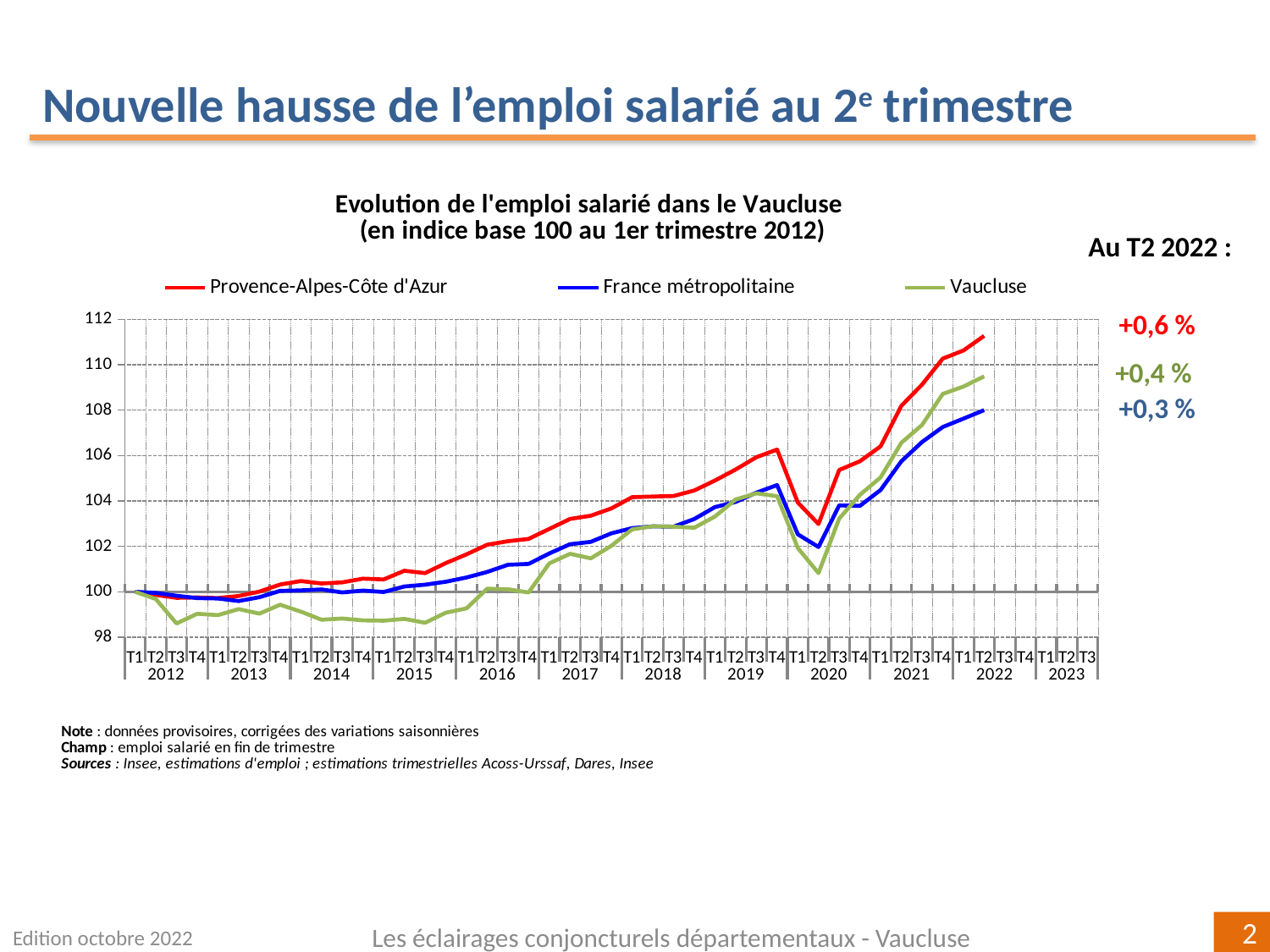
How many series does the legend list? 3 Is the value for Provence-Alpes-Côte d'Azur at T2 2022 greater or less than 110? greater What is the title of the chart? Evolution de l'emploi salarié dans le Vaucluse (en indice base 100 au 1er trimestre 2012) Is the value for Vaucluse at T2 2020 greater or less than 102? less What kind of chart is shown on the slide? line chart What is the index value of all three series at T1 2012? 100 At T3 2015, which series has the lowest index value? Vaucluse Overall, does the Provence-Alpes-Côte d'Azur line rise or fall from T1 2012 to T2 2022? rise Which colour is used for the Vaucluse line? green At T2 2022, which series has the highest index value? Provence-Alpes-Côte d'Azur Is the value for Vaucluse at T3 2014 greater or less than 100? less According to the annotation 'Au T2 2022', what is the change shown for Vaucluse? +0,4 %